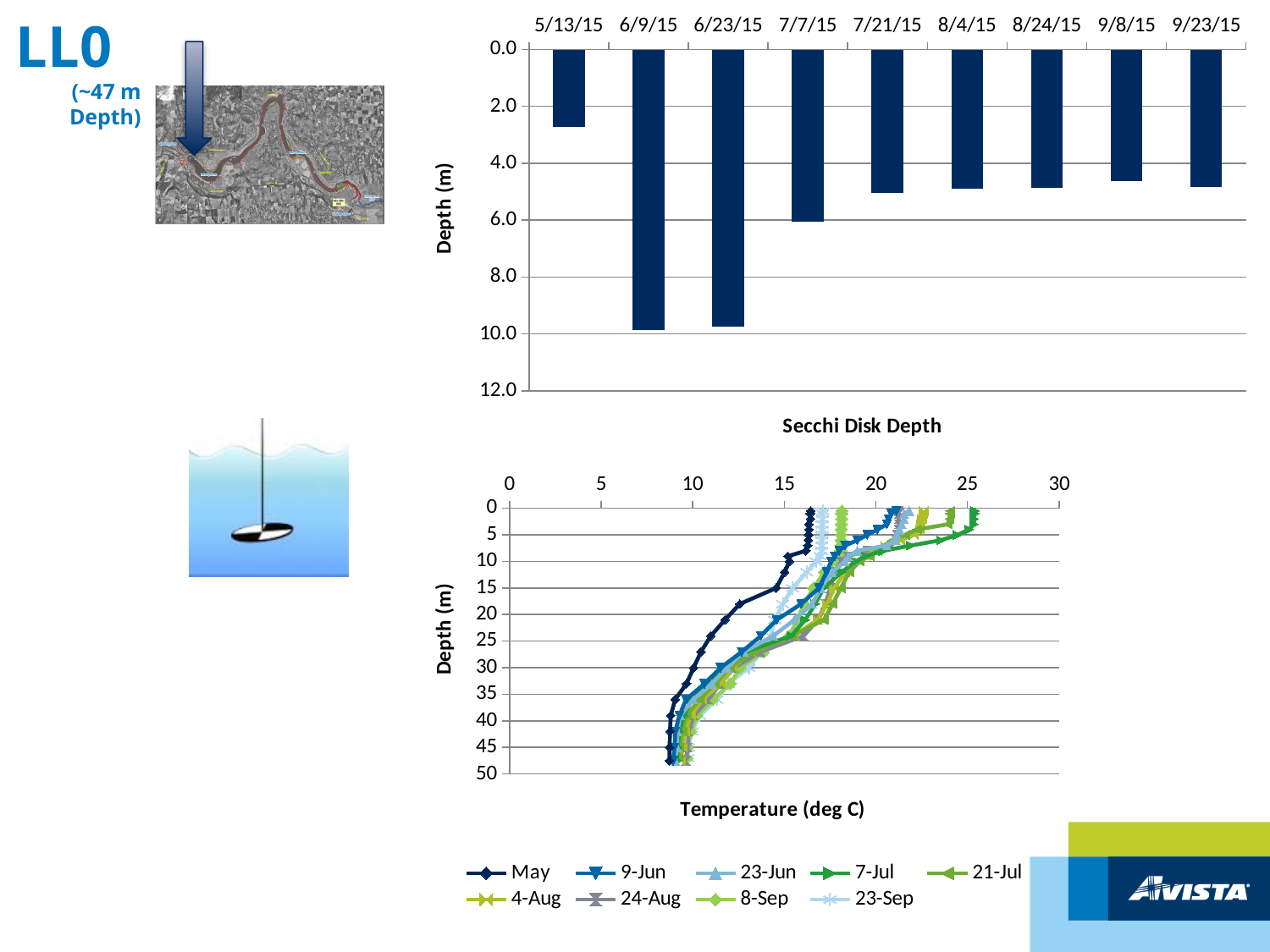
What is the y-axis label on the Temperature (deg C) chart? Depth (m) On the Secchi Disk Depth chart, is the value for 6/9/15 greater or less than 8.0? greater What type of chart is the Secchi Disk Depth chart? bar chart On the Temperature (deg C) chart, does temperature rise or fall as depth increases? fall How many dates are shown on the Secchi Disk Depth chart? 9 On the Secchi Disk Depth chart, is the value for 5/13/15 greater or less than 4.0? less What type of chart is the Temperature (deg C) chart? line chart How many series does the legend of the Temperature (deg C) chart list? 9 On the Secchi Disk Depth chart, which has the larger depth, 5/13/15 or 9/23/15? 9/23/15 On the Secchi Disk Depth chart, which date has the smallest depth? 5/13/15 On the Secchi Disk Depth chart, which has the larger depth, 7/7/15 or 7/21/15? 7/7/15 On the Secchi Disk Depth chart, is the value for 9/8/15 greater or less than 4.0? greater